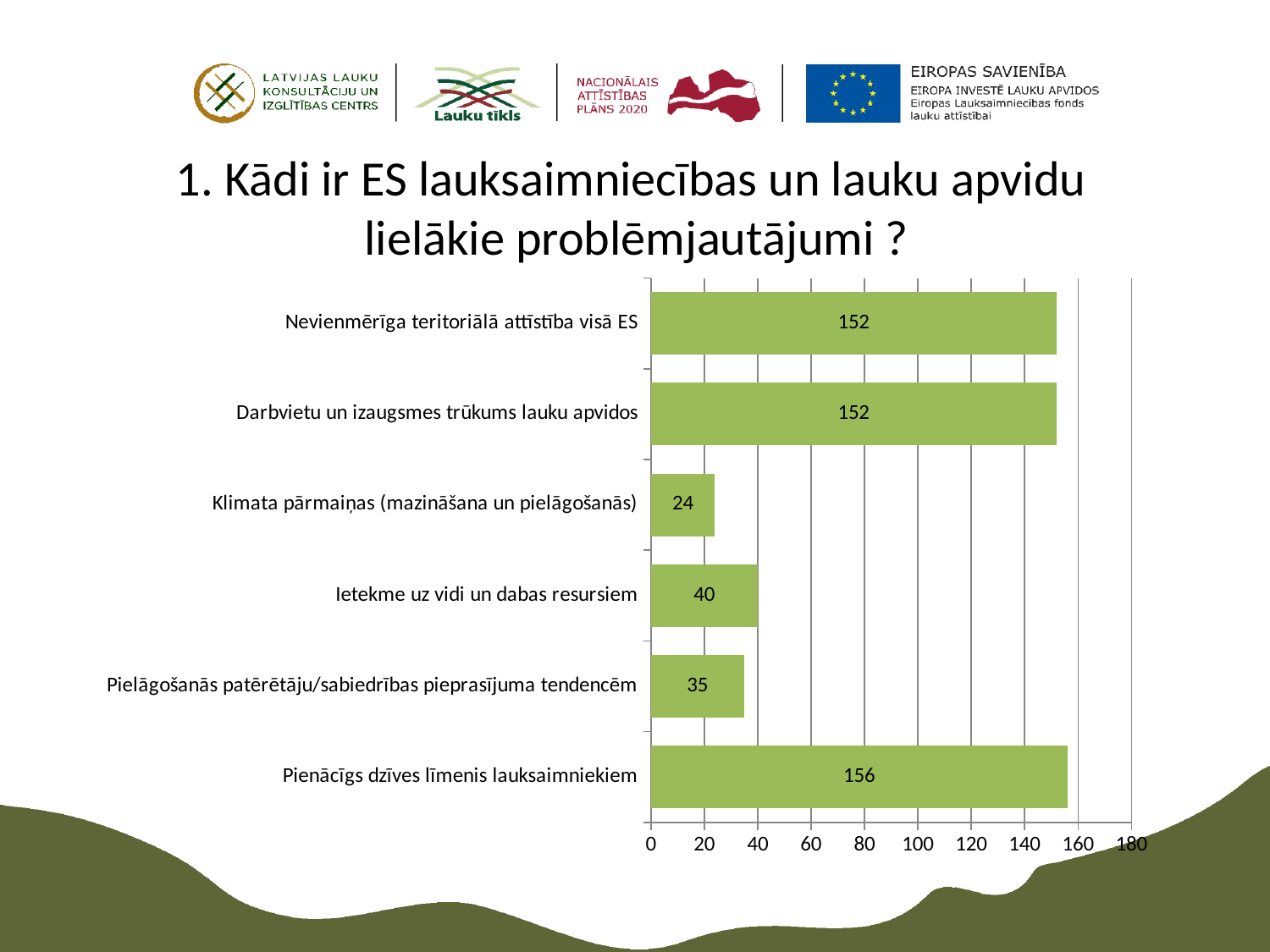
Which category has the highest value? Pienācīgs dzīves līmenis lauksaimniekiem What is the value for "Klimata pārmaiņas (mazināšana un pielāgošanās)"? 24 Which is larger: the value for "Ietekme uz vidi un dabas resursiem" or for "Pielāgošanās patērētāju/sabiedrības pieprasījuma tendencēm"? Ietekme uz vidi un dabas resursiem What is the value for "Pielāgošanās patērētāju/sabiedrības pieprasījuma tendencēm"? 35 What is the difference between the values for "Ietekme uz vidi un dabas resursiem" and "Klimata pārmaiņas (mazināšana un pielāgošanās)"? 16 What is the value for "Pienācīgs dzīves līmenis lauksaimniekiem"? 156 Is the value for "Darbvietu un izaugsmes trūkums lauku apvidos" greater or less than 140? greater What is the value for "Ietekme uz vidi un dabas resursiem"? 40 How many categories are shown in the chart? 6 Which category has the lowest value? Klimata pārmaiņas (mazināšana un pielāgošanās) What kind of chart is shown on the slide? bar chart What is the difference between the values for "Pienācīgs dzīves līmenis lauksaimniekiem" and "Nevienmērīga teritoriālā attīstība visā ES"? 4